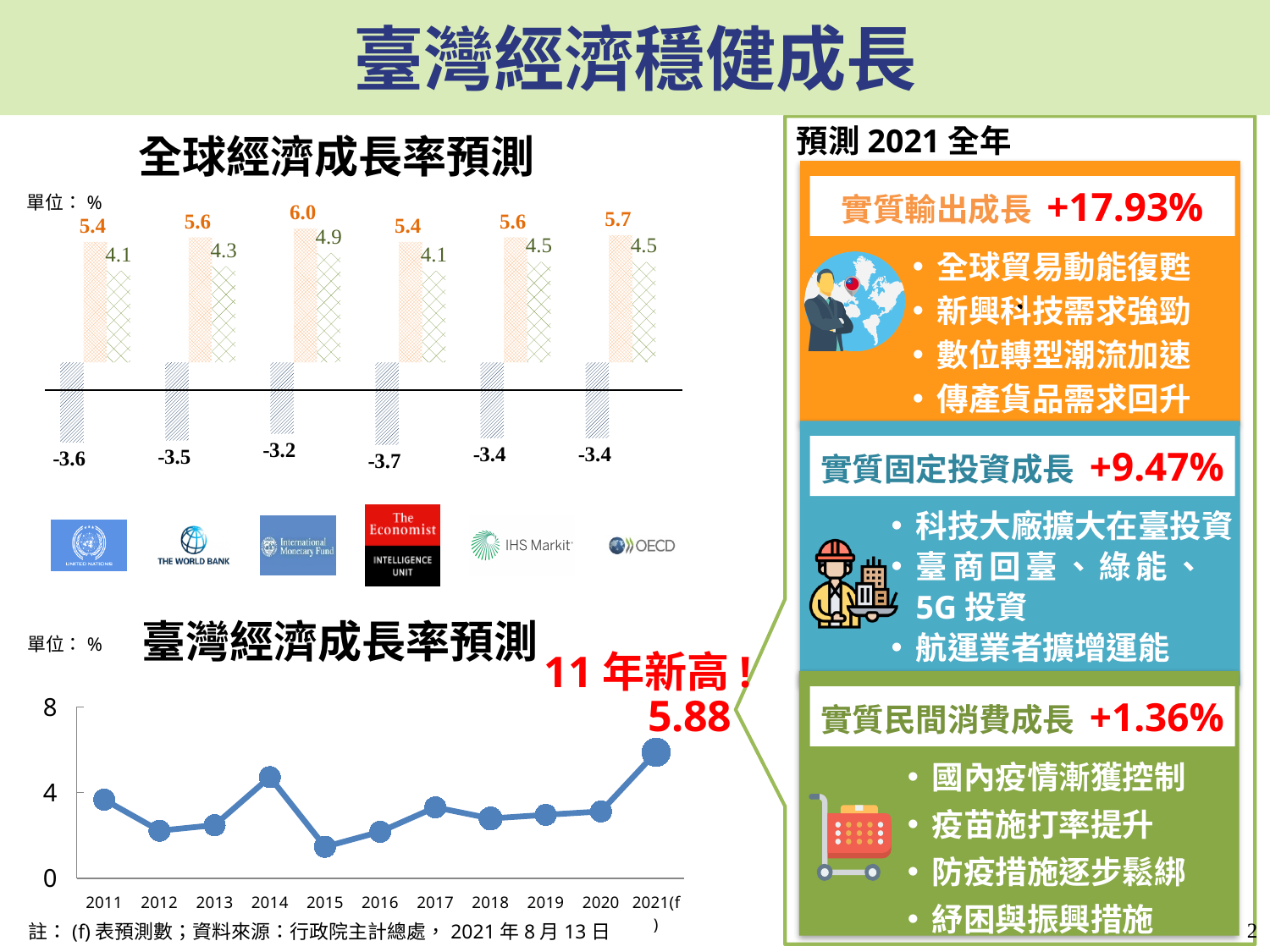
In the 全球經濟成長率預測 chart, what is the difference between the orange bar value and the green bar value for the United Nations group? 1.3 In the 全球經濟成長率預測 chart, what is the orange bar value for the OECD group? 5.7 In the 全球經濟成長率預測 chart, which institution has the lowest negative value? The Economist Intelligence Unit In the 全球經濟成長率預測 chart, what is the highest value shown for the International Monetary Fund group? 6.0 In the 臺灣經濟成長率預測 chart, is the value for 2015 greater or less than 4? less In the 全球經濟成長率預測 chart, which is larger: the green bar value for The World Bank or the green bar value for IHS Markit? IHS Markit In the 全球經濟成長率預測 chart, which institution has the highest orange bar value? International Monetary Fund In the 臺灣經濟成長率預測 chart, what is the value for 2021(f)? 5.88 How many institution groups are shown in the 全球經濟成長率預測 chart? 6 In the 全球經濟成長率預測 chart, what is the negative value shown for The Economist Intelligence Unit group? -3.7 What kind of chart is the 臺灣經濟成長率預測 chart? line chart In the 臺灣經濟成長率預測 chart, is the value for 2014 greater or less than 4? greater